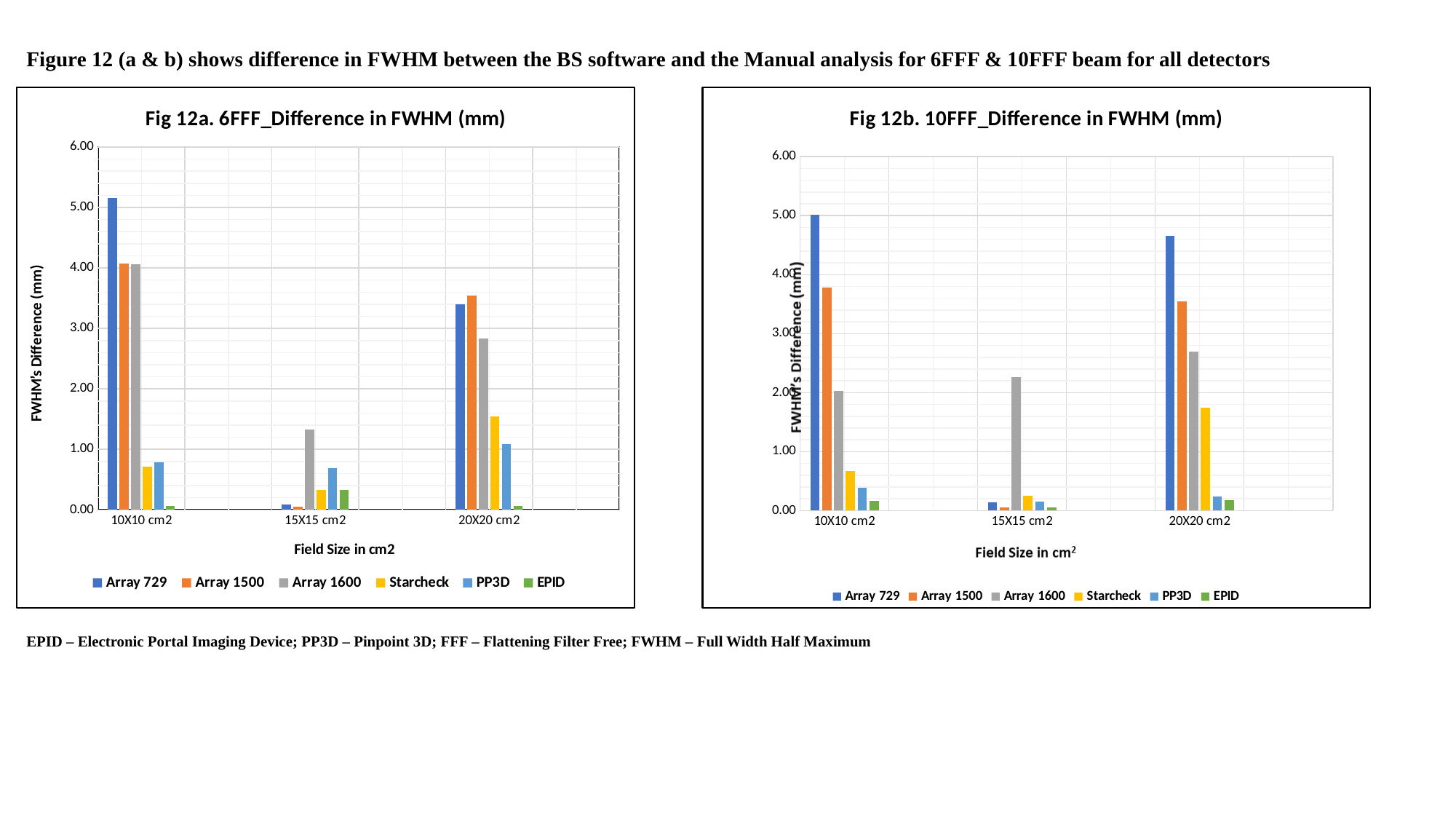
In Fig 12a. 6FFF_Difference in FWHM (mm), which detector has the highest value at 10X10 cm2? Array 729 In Fig 12b. 10FFF_Difference in FWHM (mm), which is larger at 20X20 cm2: Array 1600 or Starcheck? Array 1600 How many field size categories are shown on the x axis of Fig 12a. 6FFF_Difference in FWHM (mm)? 3 In Fig 12b. 10FFF_Difference in FWHM (mm), is the value for Array 1500 at 10X10 cm2 greater or less than 4.00? less In Fig 12a. 6FFF_Difference in FWHM (mm), is the value for Array 1600 at 20X20 cm2 greater or less than 3.00? less In Fig 12b. 10FFF_Difference in FWHM (mm), which detector has the highest value at 20X20 cm2? Array 729 In Fig 12a. 6FFF_Difference in FWHM (mm), is the value for Array 729 at 10X10 cm2 greater or less than 5.00? greater In Fig 12a. 6FFF_Difference in FWHM (mm), which detector has the highest value at 15X15 cm2? Array 1600 What kind of chart is Fig 12a. 6FFF_Difference in FWHM (mm)? Bar chart How many series does the legend of Fig 12b. 10FFF_Difference in FWHM (mm) list? 6 What is the y-axis title of Fig 12a. 6FFF_Difference in FWHM (mm)? FWHM's Difference (mm)